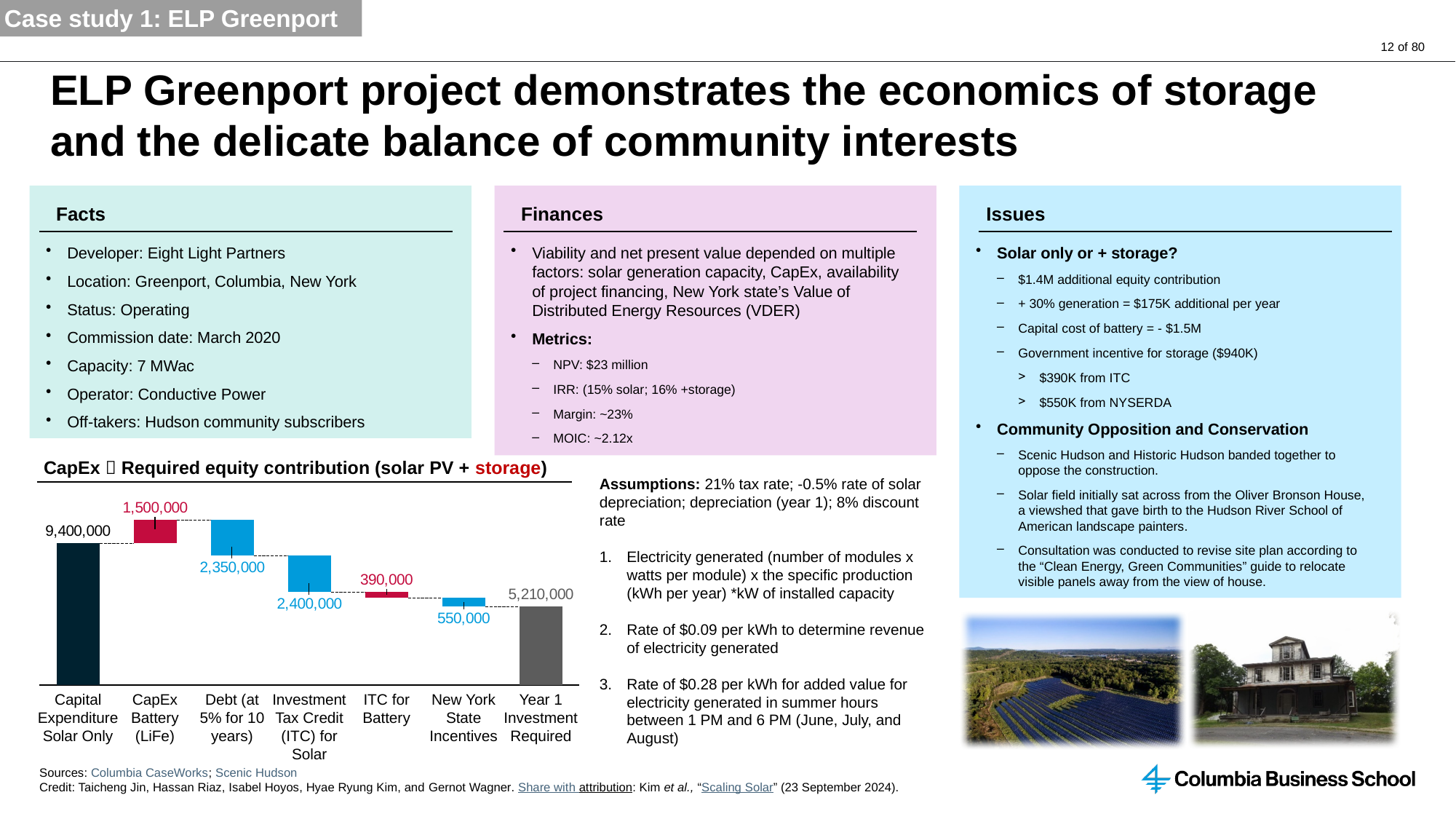
How many categories are shown on the x axis of the chart? 7 What is the value shown for Investment Tax Credit (ITC) for Solar? 2,400,000 Which category has the largest value in the chart? Capital Expenditure Solar Only What is the value shown for CapEx Battery (LiFe)? 1,500,000 What is the value shown for ITC for Battery? 390,000 What is the difference between the Capital Expenditure Solar Only value and the Year 1 Investment Required value? 4,190,000 What is the value shown for Capital Expenditure Solar Only? 9,400,000 What is the Year 1 Investment Required? 5,210,000 What is the title of the chart? CapEx Required equity contribution (solar PV + storage) What is the value shown for New York State Incentives? 550,000 What is the value shown for Debt (at 5% for 10 years)? 2,350,000 Which category has the smallest value in the chart? ITC for Battery